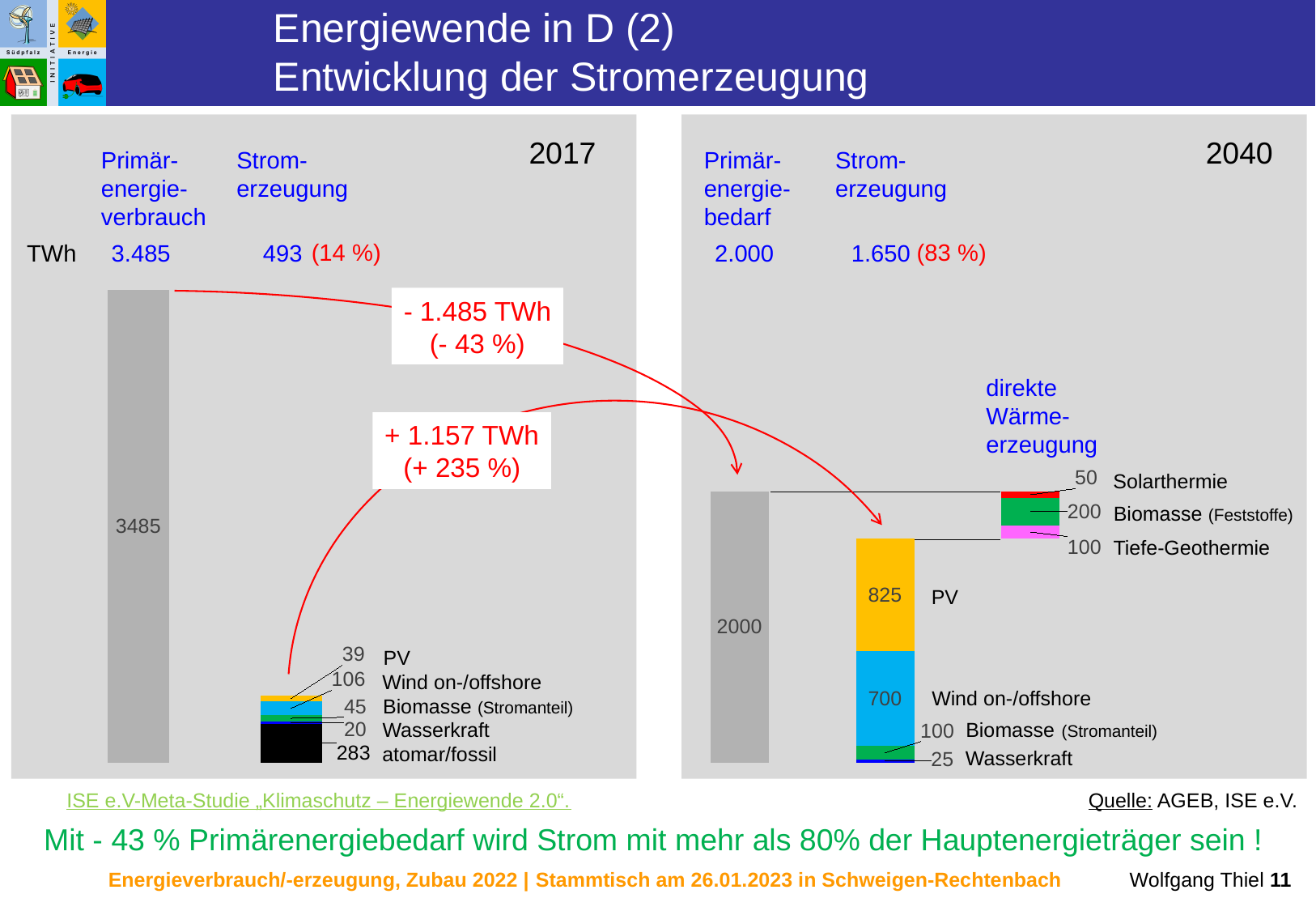
In the 2017 chart, which segment of the Stromerzeugung bar is the largest? atomar/fossil In the 2017 chart, what is the value for PV? 39 In the 2040 chart, what is the total of the direkte Wärmeerzeugung stacked bar? 350 What kind of chart is shown in the 2017 panel? Bar chart In the 2040 chart, which segment of the Stromerzeugung bar is the smallest? Wasserkraft In the 2017 chart, what is the value for atomar/fossil? 283 How many segments make up the Stromerzeugung stacked bar in the 2040 chart? 4 In the 2040 chart, what is the value for Wind on-/offshore? 700 In the 2040 chart, what is the difference between PV and Wind on-/offshore? 125 In the 2017 chart, which is larger, Wind on-/offshore or Biomasse (Stromanteil)? Wind on-/offshore In the 2017 chart, what is the total of the Stromerzeugung stacked bar? 493 In the 2040 chart, what is the value for Tiefe-Geothermie in the direkte Wärmeerzeugung bar? 100